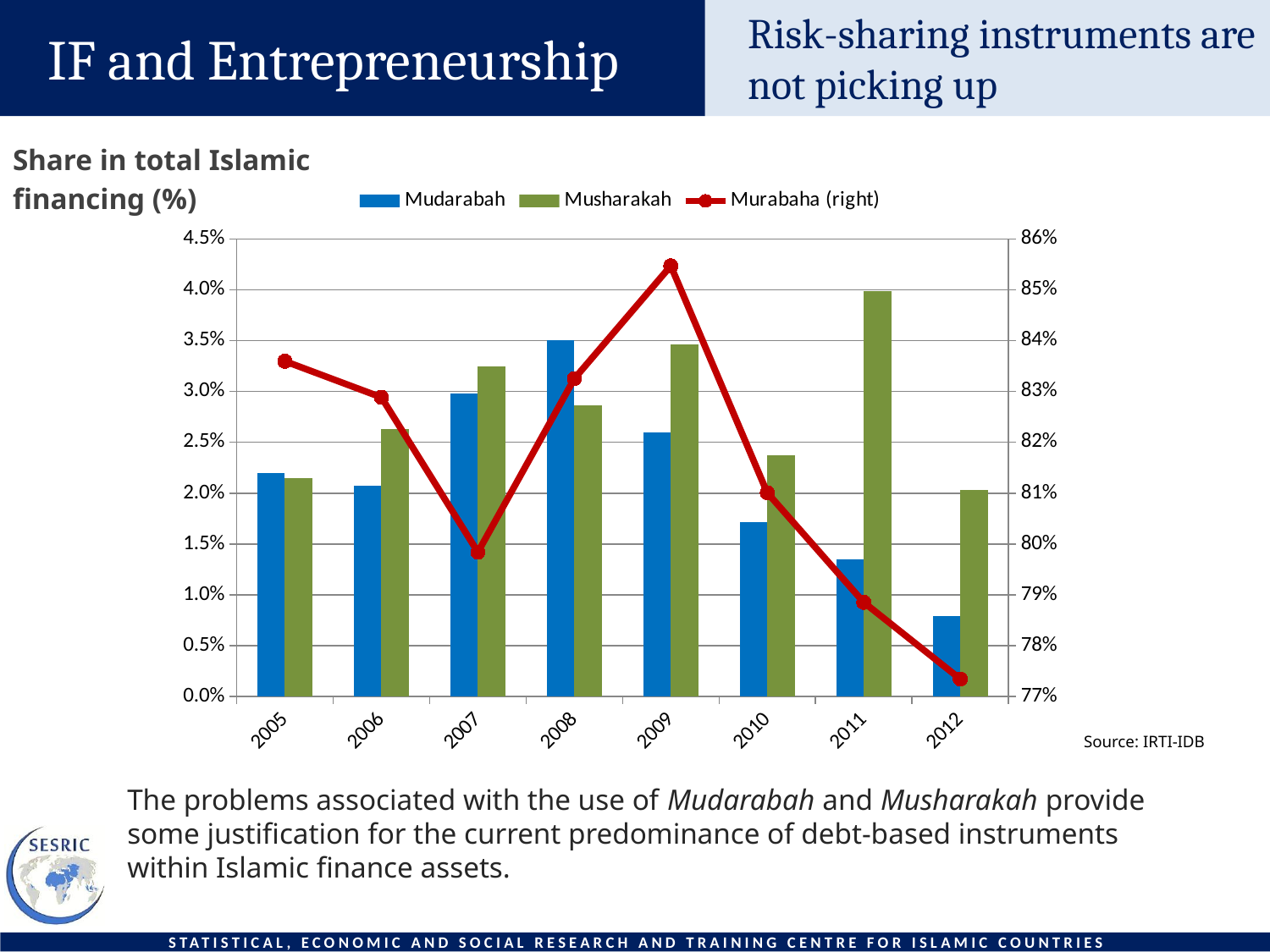
In which year is the Mudarabah share highest? 2008 Is the Murabaha value for 2007 greater or less than 80%? less In which year is the Mudarabah share lowest? 2012 In which year is the Murabaha share highest? 2009 In 2009, which is larger, the Mudarabah share or the Musharakah share? Musharakah How many series does the legend list? 3 In which year is the Murabaha share lowest? 2012 Does the Mudarabah share rise or fall from 2008 to 2012? fall What kind of chart is used to plot the Mudarabah and Musharakah series? bar chart How many years are shown on the x axis? 8 Is the Musharakah value for 2011 greater or less than 3.5%? greater In which year is the Musharakah share highest? 2011